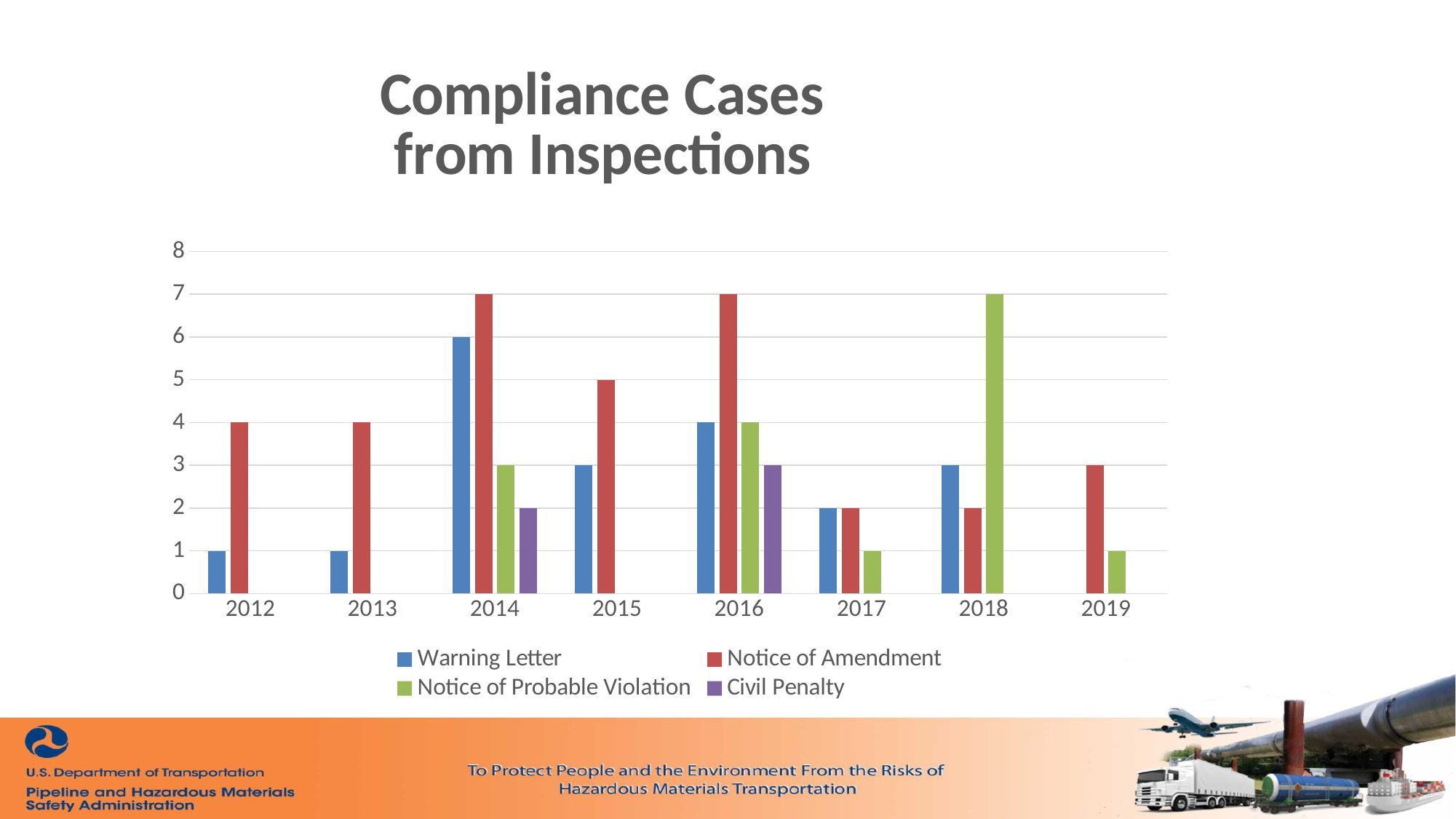
What is the difference between Notice of Amendment and Warning Letter in 2015? 2 What is the title of the chart? Compliance Cases from Inspections What is the value for Civil Penalty in 2016? 3 How many years are shown on the x axis? 8 Which is larger in 2018, Notice of Probable Violation or Warning Letter? Notice of Probable Violation What is the value for Notice of Probable Violation in 2018? 7 What is the value for Warning Letter in 2014? 6 What kind of chart is shown on the slide? Bar chart What is the value for Notice of Amendment in 2014? 7 How many series does the legend list? 4 In which year is the Warning Letter value highest? 2014 In which year is the Notice of Amendment value lowest? 2017 and 2018 (tied at 2)